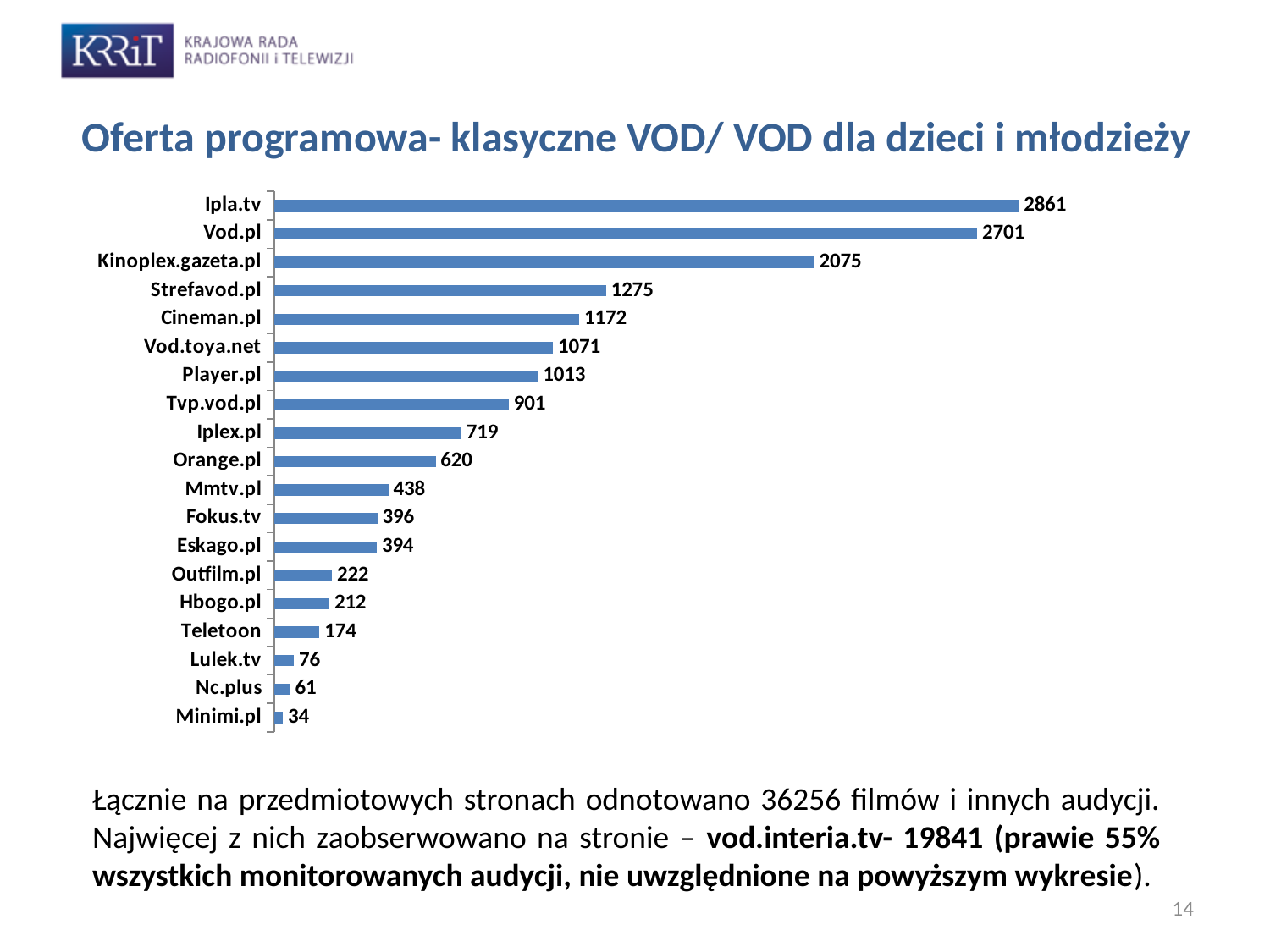
What is the value for Kinoplex.gazeta.pl? 2075 What is the difference between the values for Ipla.tv and Vod.pl? 160 Which has a larger value, Player.pl or Vod.toya.net? Vod.toya.net What is the value for Ipla.tv? 2861 What is the value for Tvp.vod.pl? 901 What is the difference between the values for Strefavod.pl and Cineman.pl? 103 How many categories are shown in the chart? 19 Which category has the highest value? Ipla.tv What is the value for Teletoon? 174 What kind of chart is shown on the slide? Bar chart What is the value for Lulek.tv? 76 Which category has the lowest value? Minimi.pl